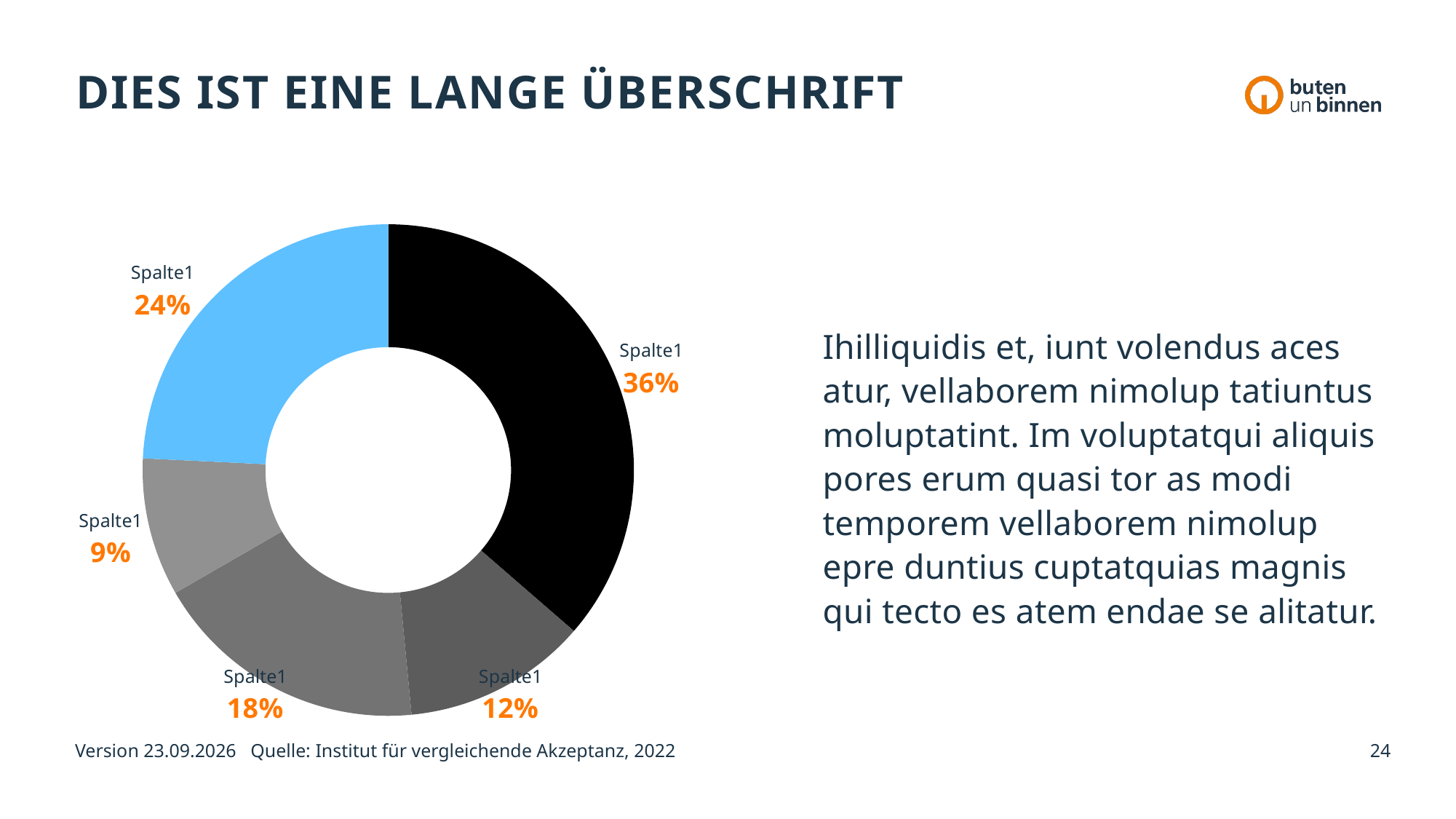
What share of the doughnut does the slice labelled 18% represent? 18% What is the value of the smallest slice in the doughnut chart? 9% Which slice is larger, the black slice or the light blue slice? the black slice How many slices does the doughnut chart have? 5 What category label is shown for every slice of the doughnut chart? Spalte1 What percentage is shown for the slice at the bottom right of the doughnut chart, next to the black slice? 12% What is the value of the largest slice in the doughnut chart? 36% What percentage is shown for the black slice of the doughnut chart? 36% What kind of chart is shown on the slide? doughnut chart What source is cited at the bottom of the slide? Institut für vergleichende Akzeptanz, 2022 What is the difference between the black slice (36%) and the light blue slice (24%)? 12 percentage points What percentage is shown for the light blue slice of the doughnut chart? 24%